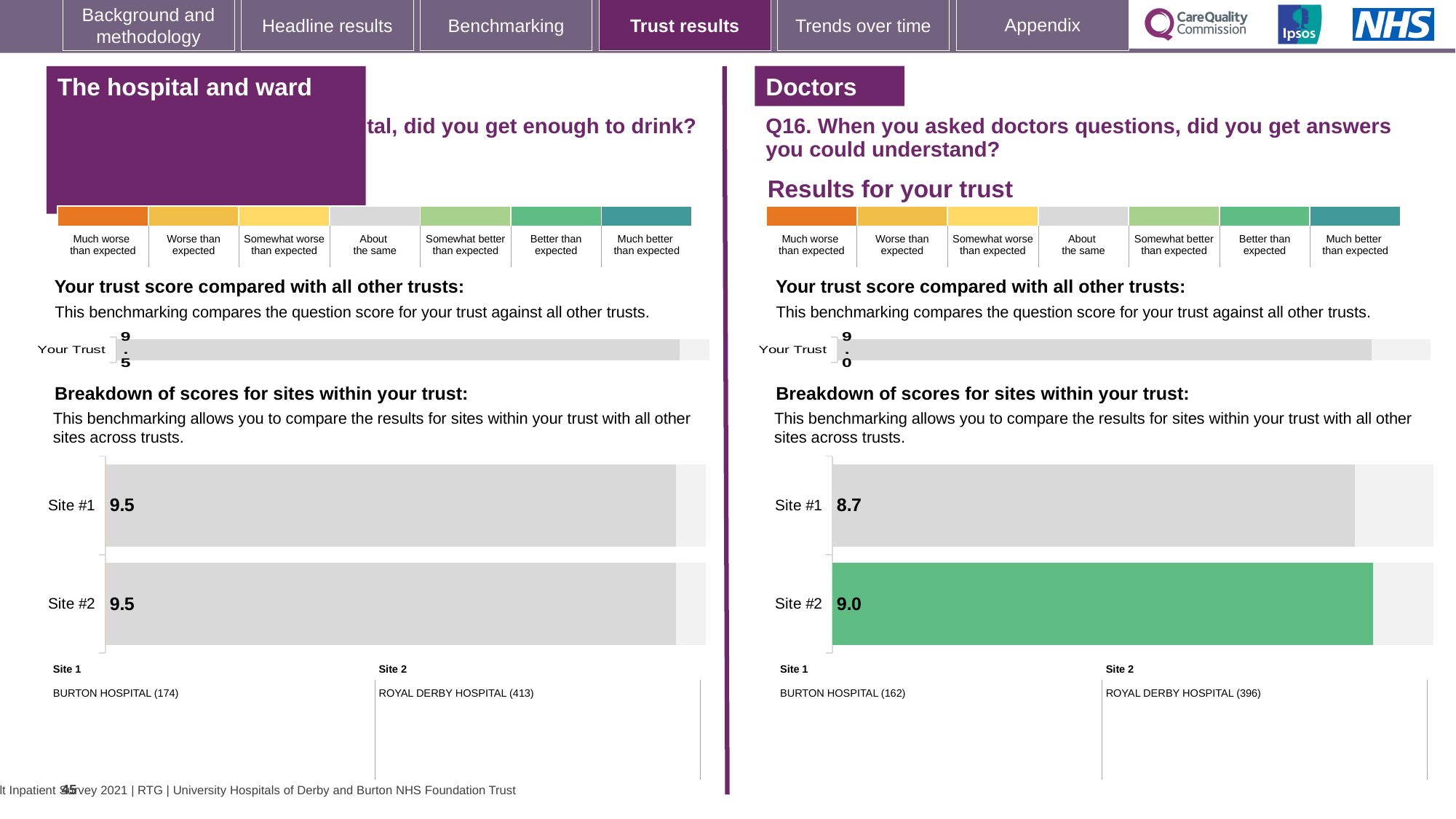
On the left-hand site breakdown chart (The hospital and ward), what is the score for Site #2? 9.5 On the right-hand (Q16, Doctors) site breakdown chart, what is the score for Site #1? 8.7 What type of chart is the right-hand (Q16, Doctors) site breakdown chart? Bar chart How many sites are shown on the left-hand site breakdown chart (The hospital and ward)? 2 On the right-hand (Q16, Doctors) 'Your Trust' chart, what is the trust score shown? 9.0 On the right-hand (Q16, Doctors) site breakdown chart, what is the difference between the Site #2 and Site #1 scores? 0.3 On the right-hand (Q16, Doctors) site breakdown chart, which site has the lower score? Site #1 On the right-hand (Q16, Doctors) site breakdown chart, what is the score for Site #2? 9.0 On the left-hand 'Your Trust' chart (The hospital and ward), what is the trust score shown? 9.5 On the right-hand (Q16, Doctors) site breakdown chart, which site's bar is coloured green? Site #2 On the right-hand (Q16, Doctors) site breakdown chart, which site has the higher score? Site #2 On the left-hand site breakdown chart (The hospital and ward), what is the score for Site #1? 9.5